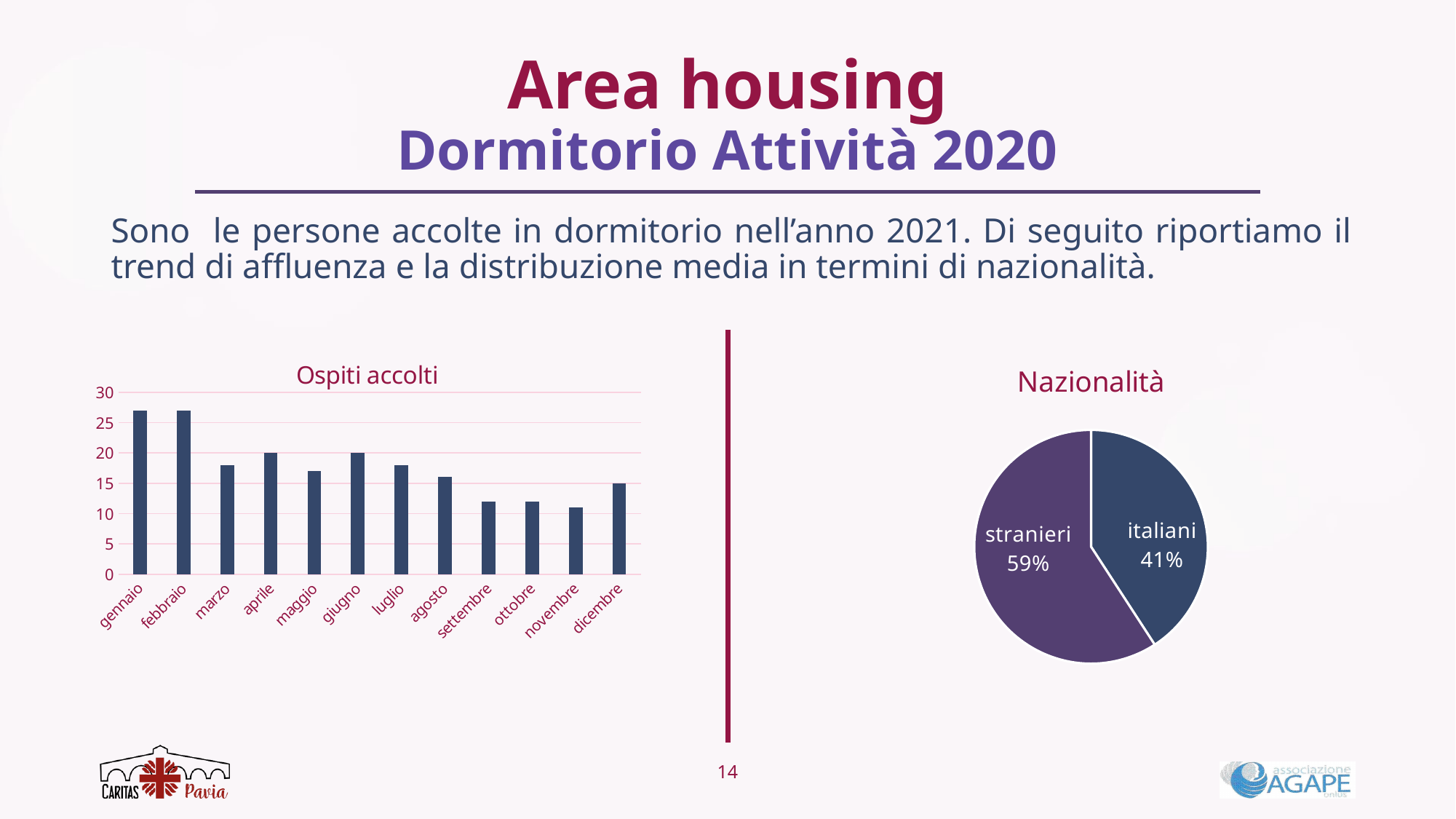
In the 'Nazionalità' chart, what is the difference in percentage points between stranieri and italiani? 18 In the 'Ospiti accolti' chart, is the value for gennaio greater or less than 25? greater How many slices does the 'Nazionalità' pie chart have? 2 What kind of chart is the 'Ospiti accolti' chart? bar chart In the 'Ospiti accolti' chart, do the values generally rise or fall from gennaio to novembre? fall In the 'Ospiti accolti' chart, is the value for novembre greater or less than 15? less How many months are shown on the x axis of the 'Ospiti accolti' chart? 12 In the 'Nazionalità' chart, what share is labelled for stranieri? 59% In the 'Nazionalità' chart, which slice is larger, stranieri or italiani? stranieri What kind of chart is the 'Nazionalità' chart? pie chart In the 'Nazionalità' chart, what share is labelled for italiani? 41% In the 'Ospiti accolti' chart, which month has the larger value, gennaio or novembre? gennaio